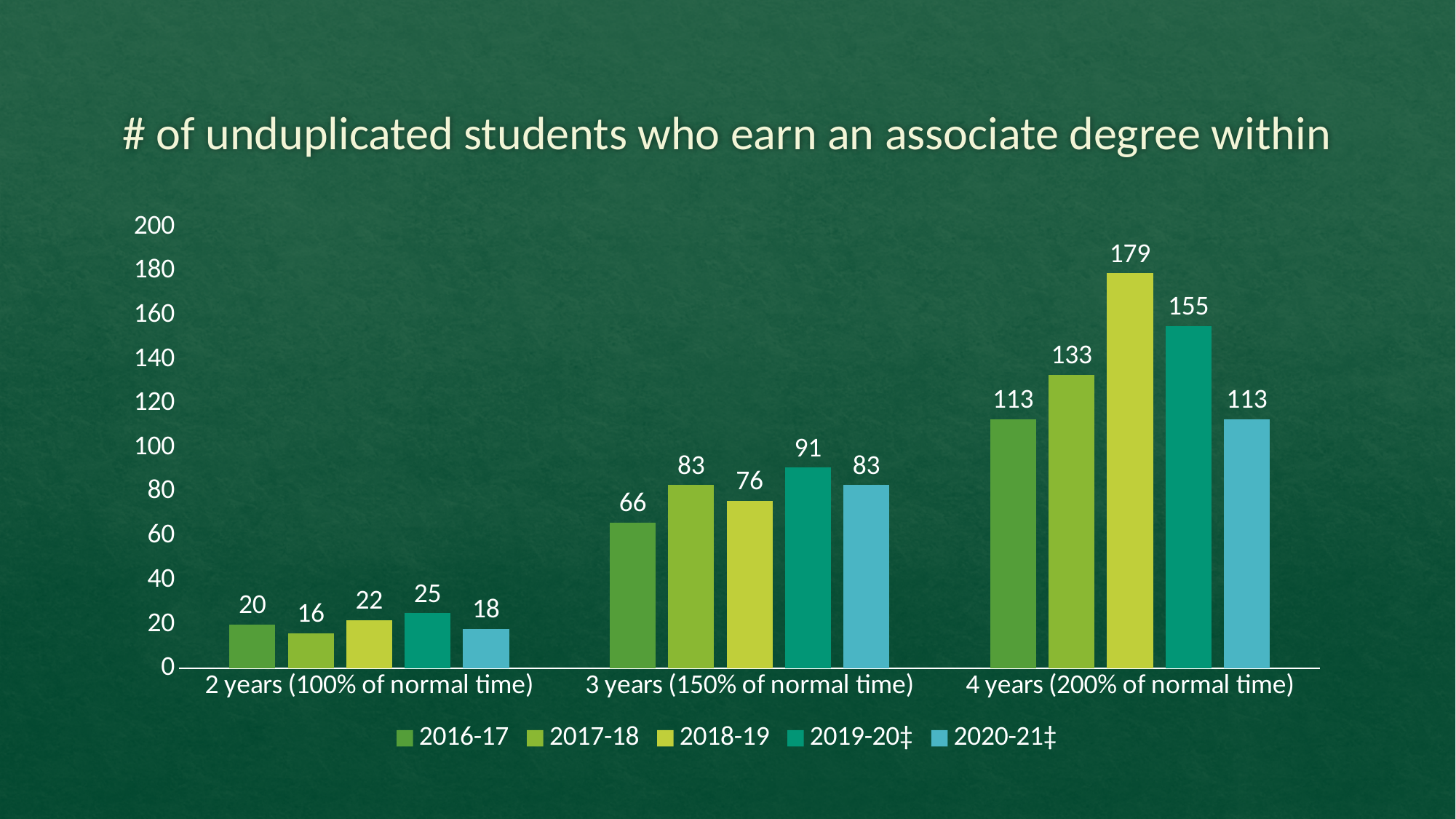
What is the difference between the 2018-19 and 2019-20‡ values in the 4 years (200% of normal time) category? 24 How many series does the legend list? 5 Which series has the lowest value in the 2 years (100% of normal time) category? 2017-18 Which series has the highest value in the 4 years (200% of normal time) category? 2018-19 What kind of chart is shown on the slide? bar chart In the 3 years (150% of normal time) category, which is larger: the 2019-20‡ value or the 2018-19 value? 2019-20‡ What is the value for 2016-17 in the 3 years (150% of normal time) category? 66 What is the value for 2018-19 in the 4 years (200% of normal time) category? 179 What is the value for 2019-20‡ in the 2 years (100% of normal time) category? 25 How many categories are shown on the x axis? 3 What is the title of the chart? # of unduplicated students who earn an associate degree within Do the 2016-17 values rise or fall from the 2 years category to the 4 years category? rise